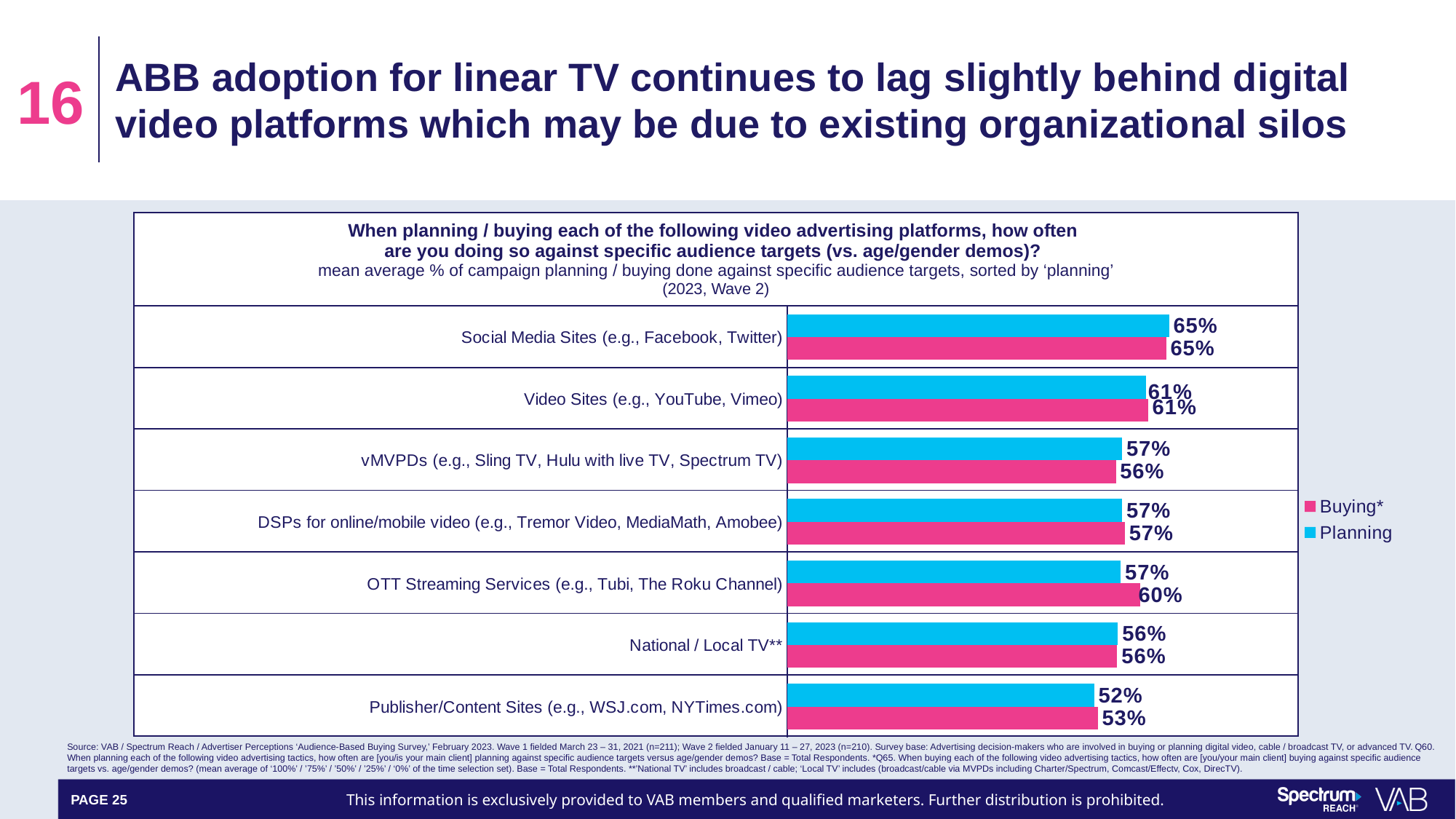
How many video advertising platforms are shown in the chart? 7 What is the Buying* value for OTT Streaming Services (e.g., Tubi, The Roku Channel)? 60% What kind of chart is shown on the slide? Bar chart What is the Planning value for Social Media Sites (e.g., Facebook, Twitter)? 65% What is the Buying* value for National / Local TV**? 56% Which colour represents the Planning series in the chart? Blue For OTT Streaming Services, which is larger: the Buying* value or the Planning value? Buying* What is the difference between the Planning values for Social Media Sites and Publisher/Content Sites? 13% Which platform has the lowest Buying* value? Publisher/Content Sites (e.g., WSJ.com, NYTimes.com) How many series does the legend list? 2 Which platform has the highest Planning value? Social Media Sites (e.g., Facebook, Twitter) What is the Planning value for Publisher/Content Sites (e.g., WSJ.com, NYTimes.com)? 52%